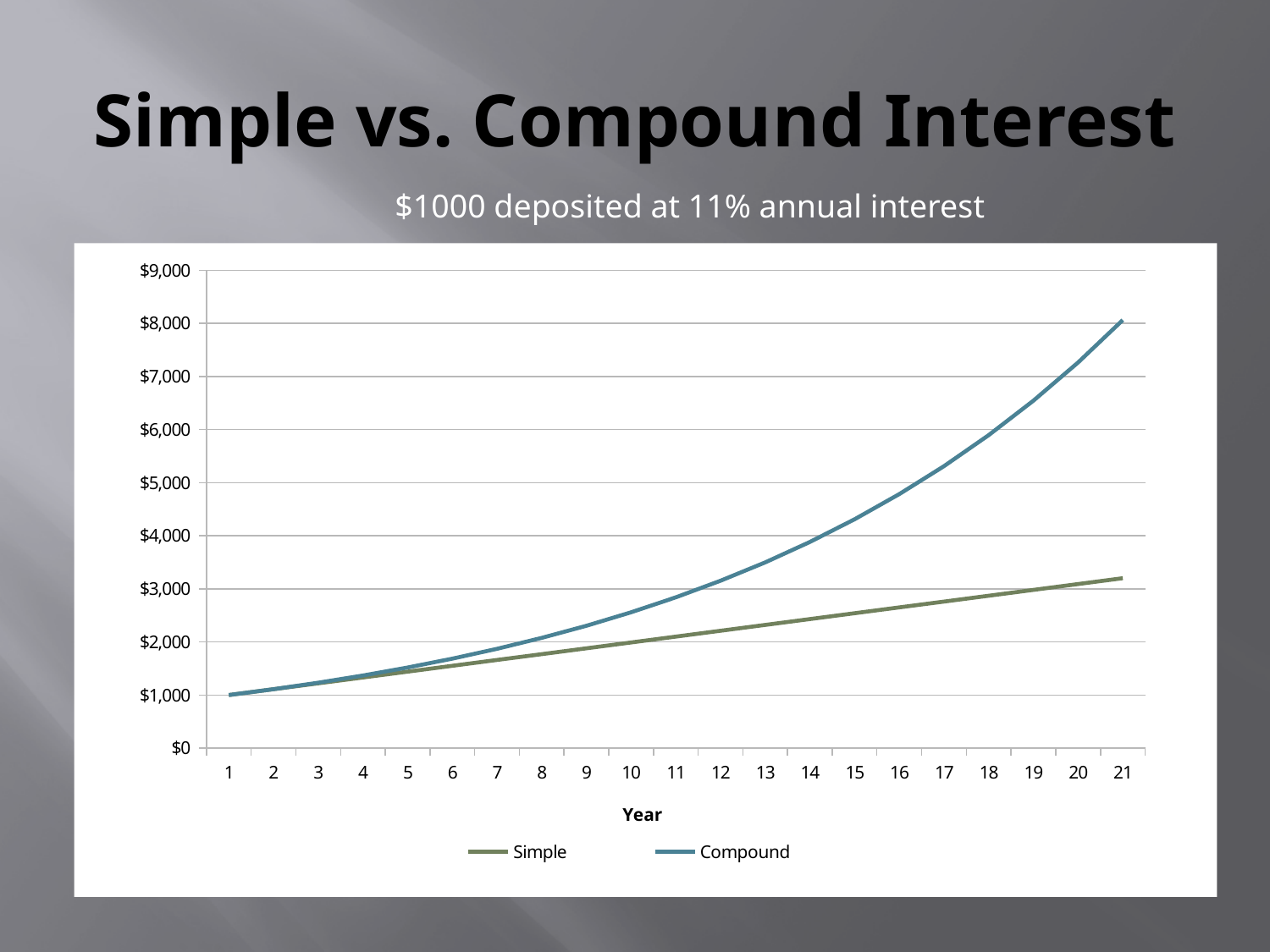
Do the values of the Compound series rise or fall as the year increases? rise Which series has the higher value at year 21, Simple or Compound? Compound Is the value of the Compound series at year 19 greater or less than $6,000? greater Is the value of the Simple series at year 21 greater or less than $3,000? greater What is the title of the x axis? Year How many series does the legend list? 2 Is the value of the Compound series at year 21 greater or less than $7,000? greater What kind of chart is shown on the slide? line chart What is the title of the slide? Simple vs. Compound Interest How many years are plotted along the x axis? 21